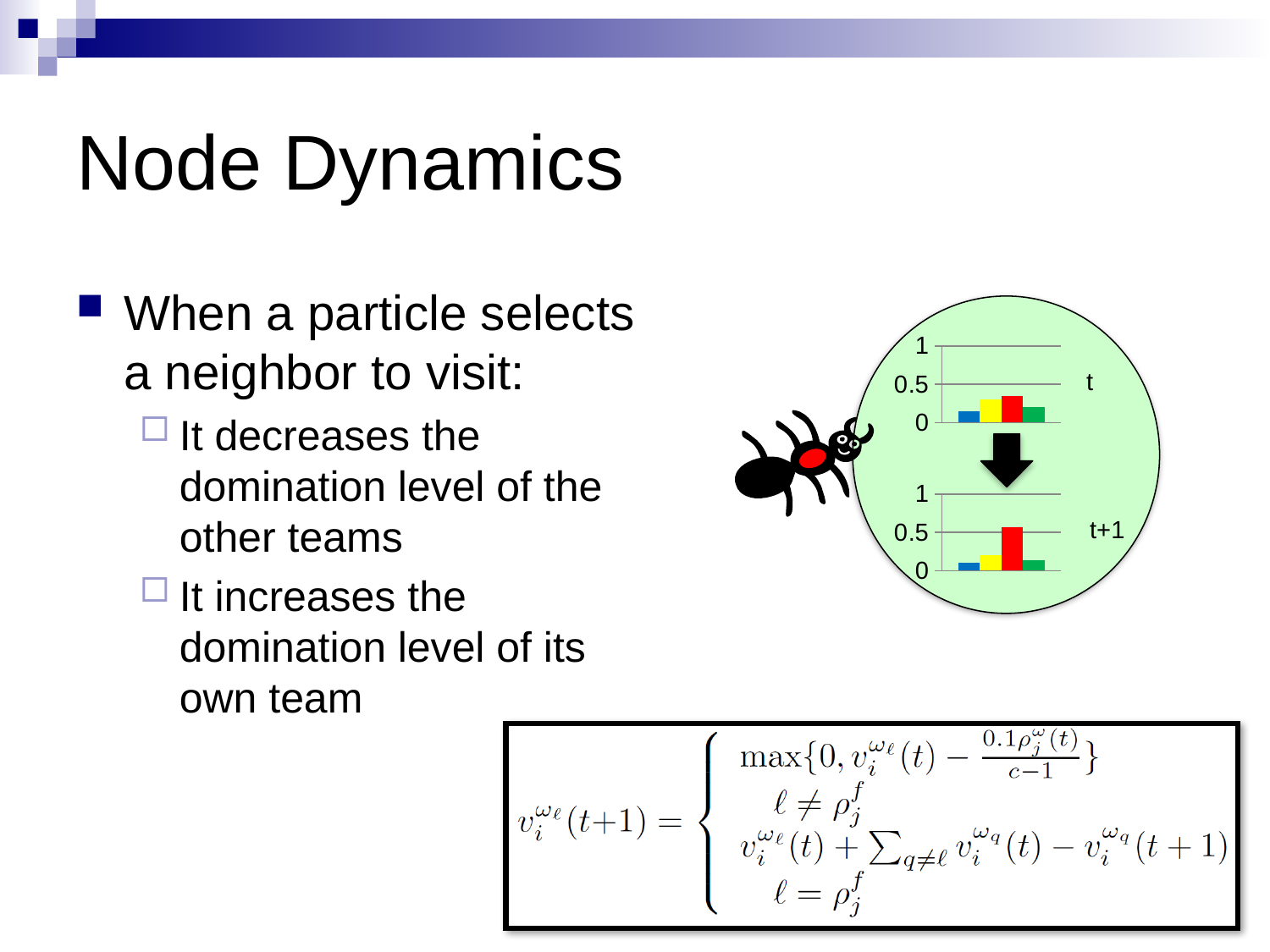
What kind of chart is the top chart labeled t inside the green circle? bar chart In the bottom chart labeled t+1, is the value of the green bar greater or less than 0.5? less In the bottom chart labeled t+1, which colored bar is the tallest? red How many bars does the top chart labeled t show? 4 In the top chart labeled t, is the value of the blue bar greater or less than 0.5? less In the top chart labeled t, which colored bar is the tallest? red In the bottom chart labeled t+1, which is larger, the red bar or the yellow bar? red How many bars does the bottom chart labeled t+1 show? 4 In the top chart labeled t, is the value of the red bar greater or less than 0.5? less In the top chart labeled t, which is larger, the red bar or the blue bar? red What time labels are shown next to the top and bottom charts in the green circle? t and t+1 What is the highest value shown on the y axis of the two charts in the green circle? 1